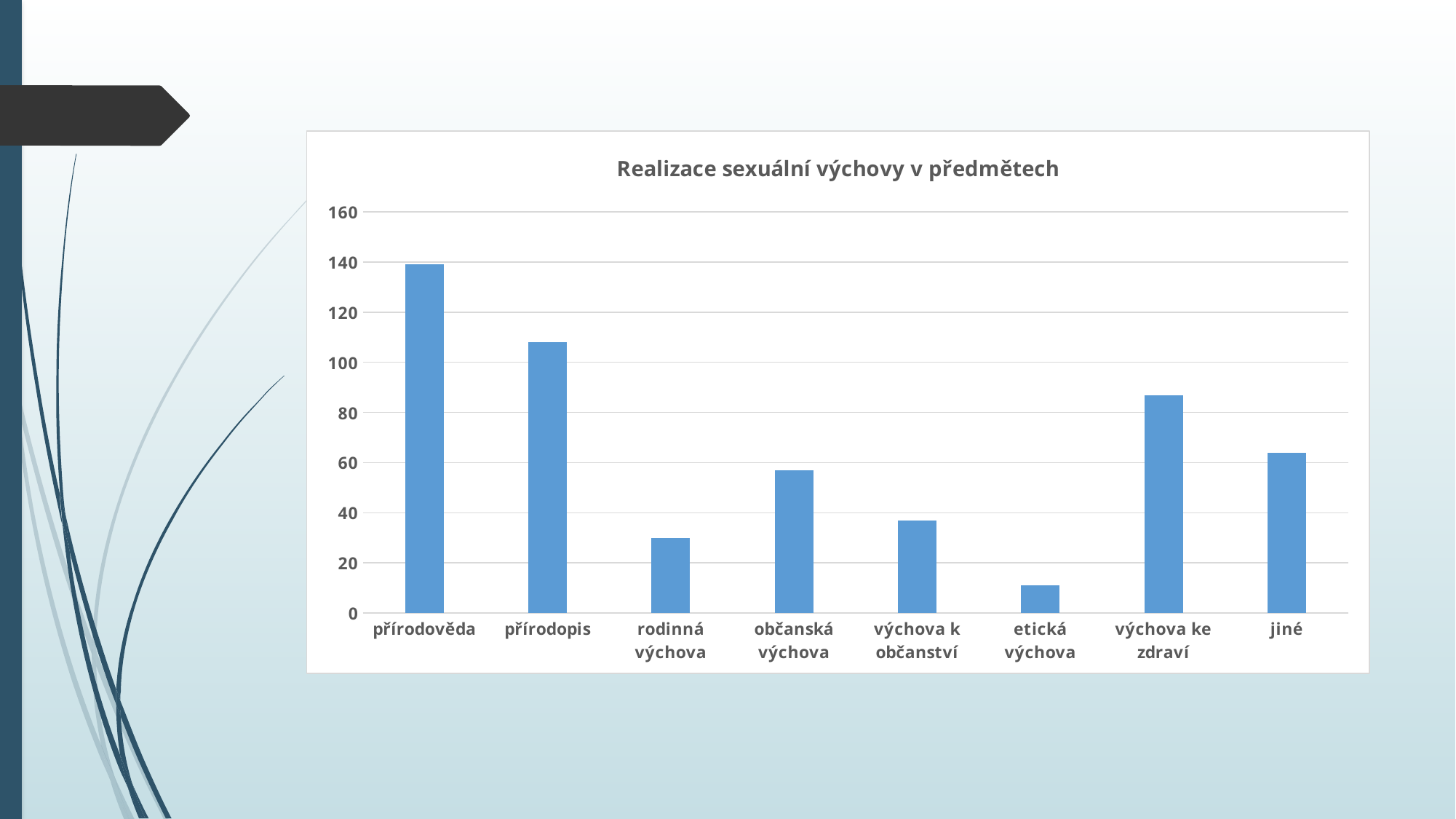
Is the value for výchova ke zdraví greater or less than 80? greater Which has a larger value, občanská výchova or výchova k občanství? občanská výchova Which category has the highest value in the chart? přírodověda Which category has the lowest value in the chart? etická výchova What type of chart is shown on the slide? bar chart What is the title of the chart? Realizace sexuální výchovy v předmětech Is the value for etická výchova greater or less than 20? less Which has a larger value, jiné or výchova ke zdraví? výchova ke zdraví Is the value for přírodověda greater or less than 120? greater How many categories are shown on the x axis of the chart? 8